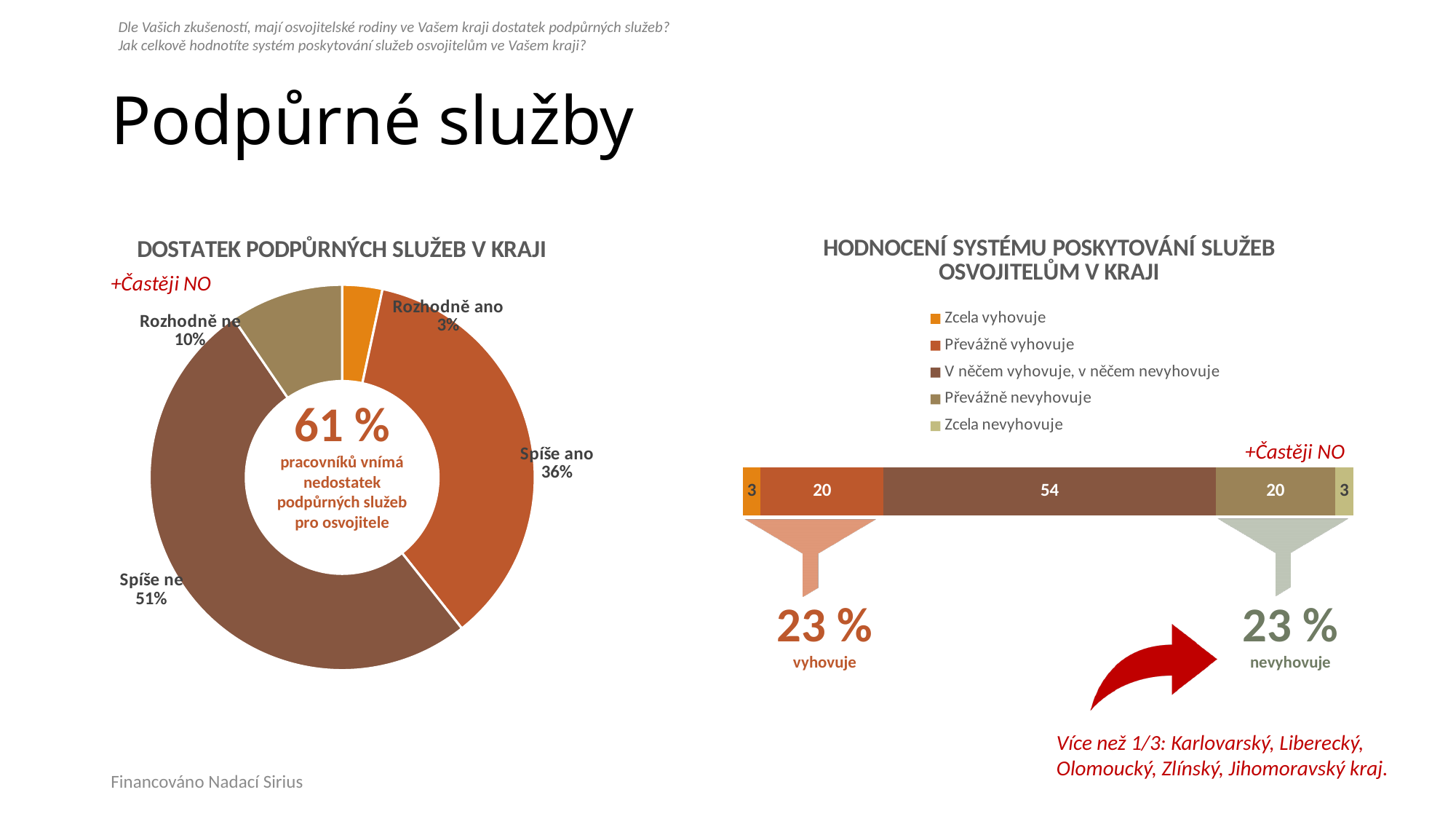
In the chart 'DOSTATEK PODPŮRNÝCH SLUŽEB V KRAJI', how many categories are shown? 4 In the chart 'DOSTATEK PODPŮRNÝCH SLUŽEB V KRAJI', what is the value for 'Spíše ne'? 51% In the chart 'HODNOCENÍ SYSTÉMU POSKYTOVÁNÍ SLUŽEB OSVOJITELŮM V KRAJI', what is the total of the stacked bar? 100 In the chart 'HODNOCENÍ SYSTÉMU POSKYTOVÁNÍ SLUŽEB OSVOJITELŮM V KRAJI', what is the value for 'Převážně vyhovuje'? 20 In the chart 'DOSTATEK PODPŮRNÝCH SLUŽEB V KRAJI', what is the value for 'Rozhodně ano'? 3% In the chart 'DOSTATEK PODPŮRNÝCH SLUŽEB V KRAJI', what is the difference between 'Spíše ne' and 'Spíše ano'? 15% In the chart 'DOSTATEK PODPŮRNÝCH SLUŽEB V KRAJI', which category has the largest share? Spíše ne In the chart 'DOSTATEK PODPŮRNÝCH SLUŽEB V KRAJI', which category has the smallest share? Rozhodně ano What type of chart is 'DOSTATEK PODPŮRNÝCH SLUŽEB V KRAJI'? Doughnut chart In the chart 'HODNOCENÍ SYSTÉMU POSKYTOVÁNÍ SLUŽEB OSVOJITELŮM V KRAJI', which series is larger: 'Zcela vyhovuje' or 'Převážně nevyhovuje'? Převážně nevyhovuje In the chart 'HODNOCENÍ SYSTÉMU POSKYTOVÁNÍ SLUŽEB OSVOJITELŮM V KRAJI', what is the value for 'V něčem vyhovuje, v něčem nevyhovuje'? 54 In the chart 'HODNOCENÍ SYSTÉMU POSKYTOVÁNÍ SLUŽEB OSVOJITELŮM V KRAJI', how many series does the legend list? 5